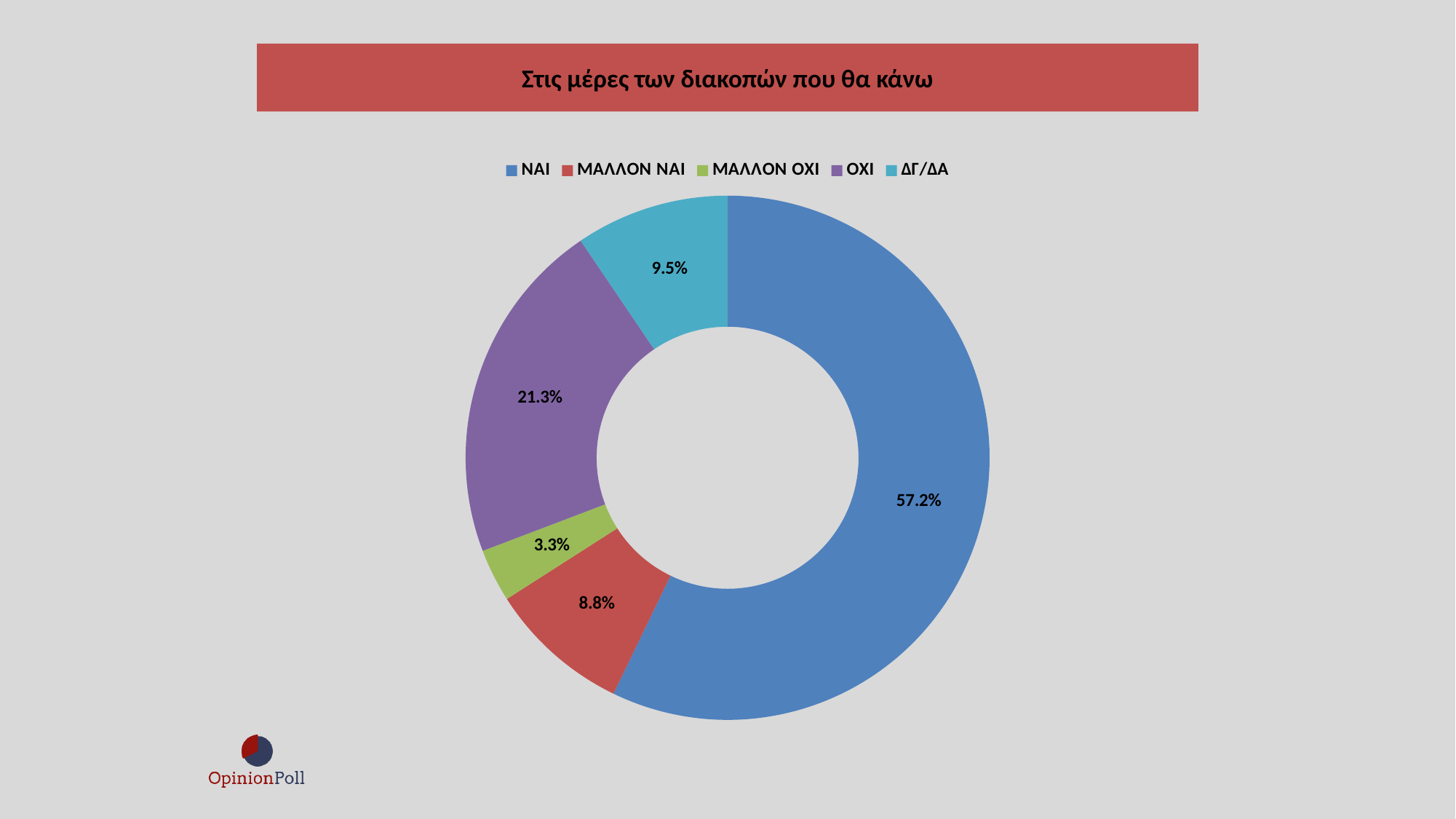
Which category has the largest share? ΝΑΙ Which category has the smallest share? ΜΑΛΛΟΝ ΟΧΙ How many categories does the legend list? 5 What kind of chart is shown on the slide? Doughnut (pie) chart What is the value for ΜΑΛΛΟΝ ΟΧΙ? 3.3% What is the value for ΟΧΙ? 21.3% What is the difference between the values for ΝΑΙ and ΟΧΙ? 35.9% What is the value for ΝΑΙ? 57.2% What is the value for ΔΓ/ΔΑ? 9.5% Which is larger, the value for ΔΓ/ΔΑ or the value for ΜΑΛΛΟΝ ΝΑΙ? ΔΓ/ΔΑ What is the title of the chart? Στις μέρες των διακοπών που θα κάνω What is the value for ΜΑΛΛΟΝ ΝΑΙ? 8.8%